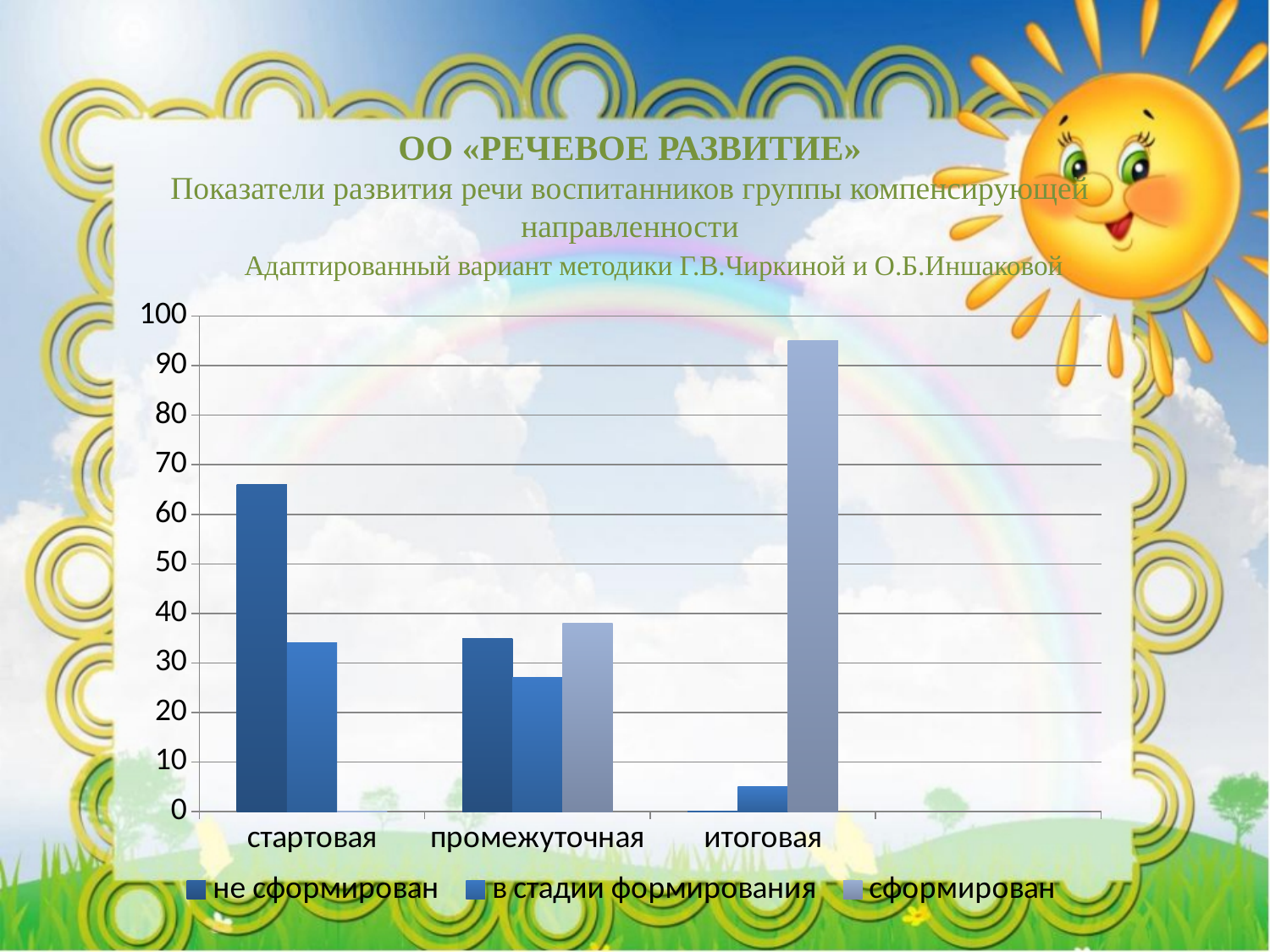
In which category is the 'сформирован' series highest? итоговая Is the value for 'в стадии формирования' in the 'промежуточная' category greater or less than 30? less How many series does the chart legend list? 3 How many categories are shown on the x axis of the chart? 3 Is the value for 'сформирован' in the 'промежуточная' category greater or less than 30? greater Which is larger: 'не сформирован' in 'стартовая' or 'не сформирован' in 'промежуточная'? стартовая Is the value for 'сформирован' in the 'итоговая' category greater or less than 90? greater What is the first series listed in the chart legend? не сформирован What kind of chart is shown on the slide? bar chart Does the 'не сформирован' series rise or fall from 'стартовая' to 'итоговая'? fall In which category is the 'не сформирован' series lowest? итоговая